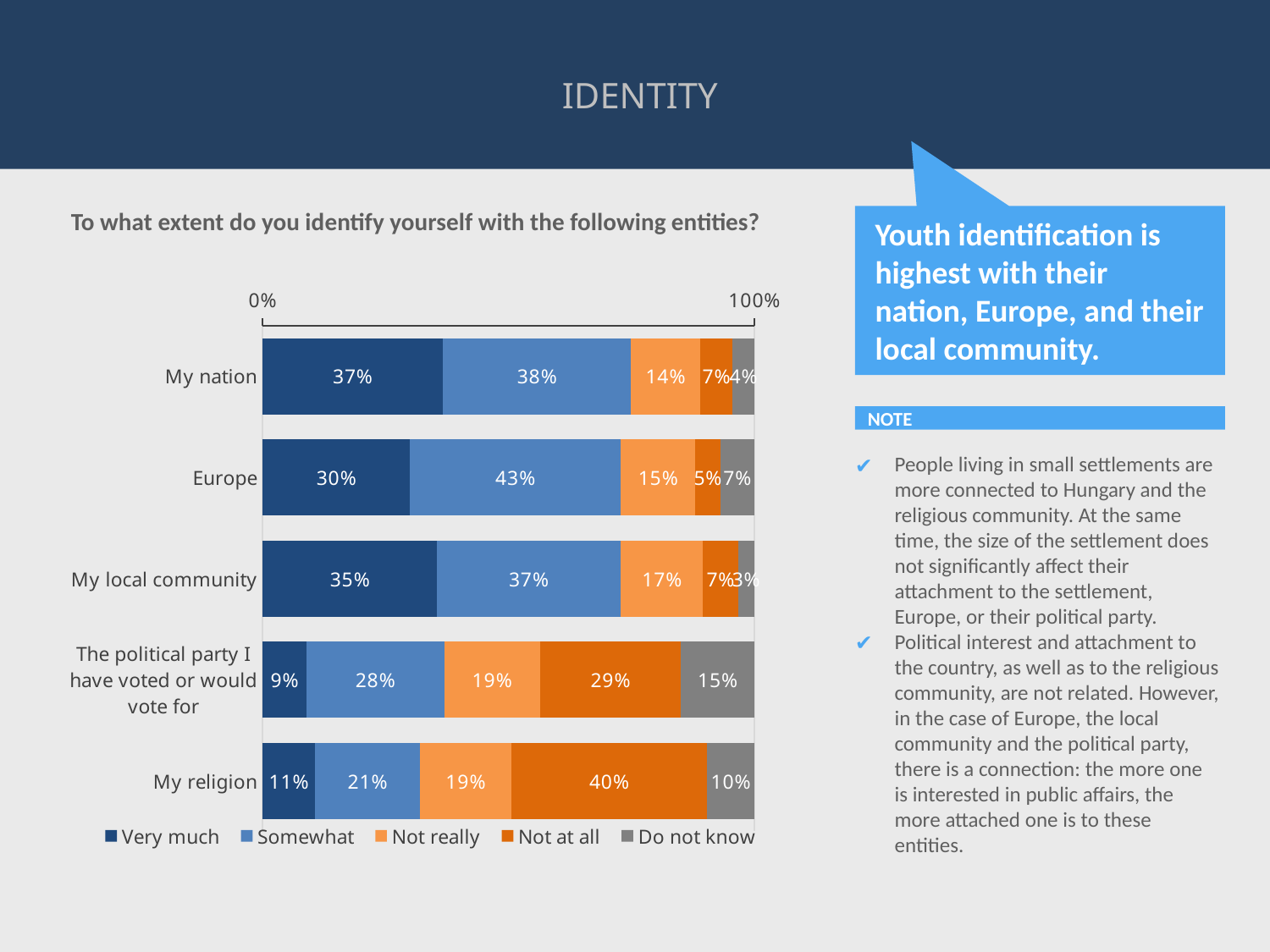
What is the combined 'Very much' and 'Somewhat' share for 'Europe'? 73% How many entities (categories) are shown in the chart? 5 What is the 'Not at all' value for 'My religion'? 40% What is the difference between the 'Not at all' values for 'My religion' and 'My nation'? 33% Which entity has the highest 'Very much' share? My nation What type of chart is shown on the slide? Stacked bar chart Which is larger: the 'Somewhat' value for 'My local community' or for 'My religion'? My local community How many series does the legend list? 5 What percentage of respondents identify 'Very much' with 'My nation'? 37% Which entity has the lowest 'Very much' share? The political party I have voted or would vote for What is the 'Do not know' value for 'The political party I have voted or would vote for'? 15% What is the 'Somewhat' value for 'Europe'? 43%